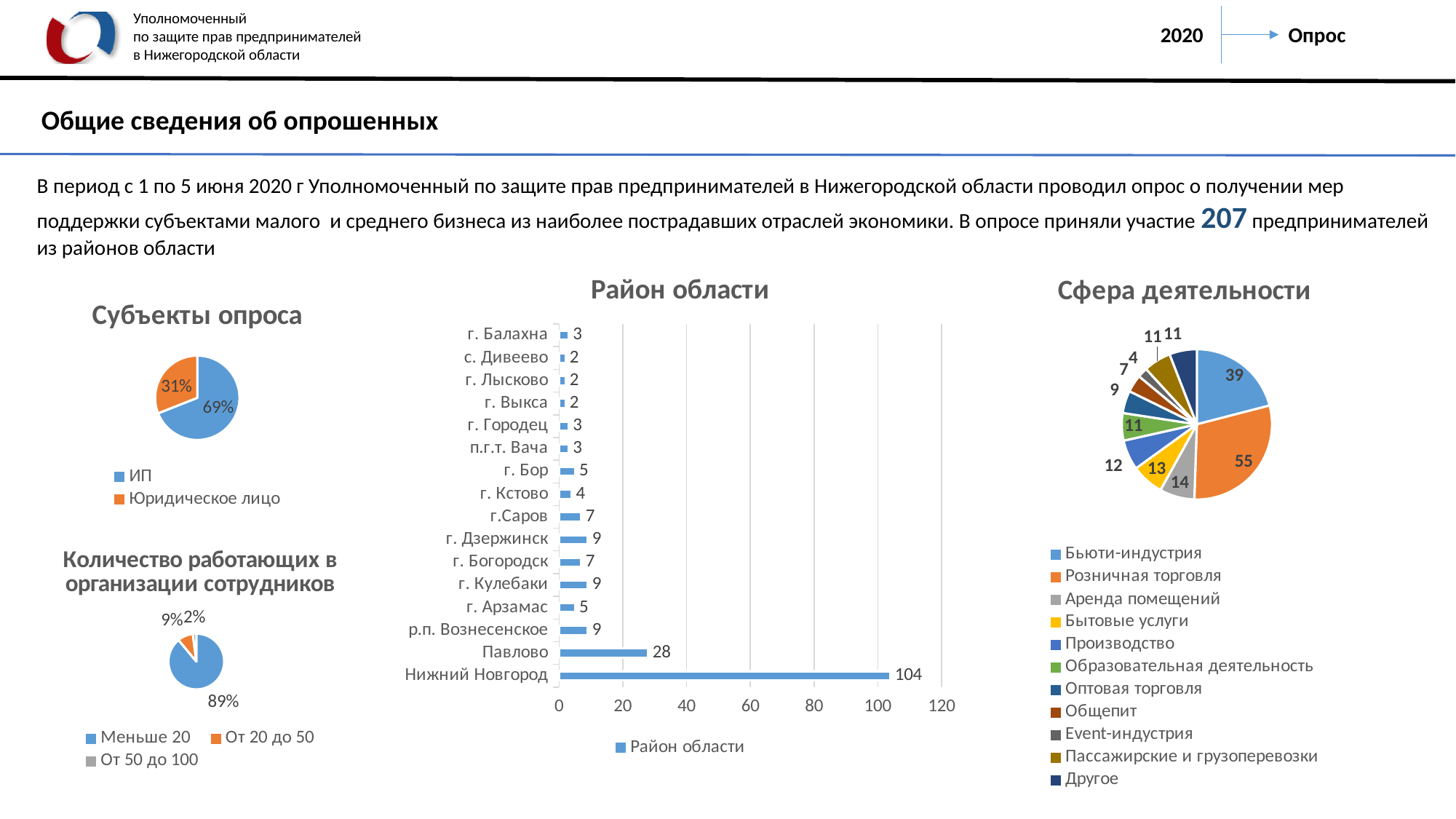
In the 'Район области' chart, what is the value for Нижний Новгород? 104 In the 'Сфера деятельности' pie chart, what is the value for Розничная торговля? 55 In the 'Район области' chart, what is the value for Павлово? 28 In the 'Субъекты опроса' pie chart, what share is ИП? 69% In the 'Район области' chart, how many districts are listed? 16 In the 'Район области' chart, what is the difference between Нижний Новгород and Павлово? 76 In the 'Район области' chart, which district has the highest value? Нижний Новгород How many entries does the legend of the 'Сфера деятельности' pie chart list? 11 In the 'Сфера деятельности' pie chart, which category has the largest value? Розничная торговля In the 'Количество работающих в организации сотрудников' pie chart, what share is 'Меньше 20'? 89% In the 'Район области' chart, which is larger: г. Дзержинск or г. Кстово? г. Дзержинск What kind of chart is 'Район области'? bar chart